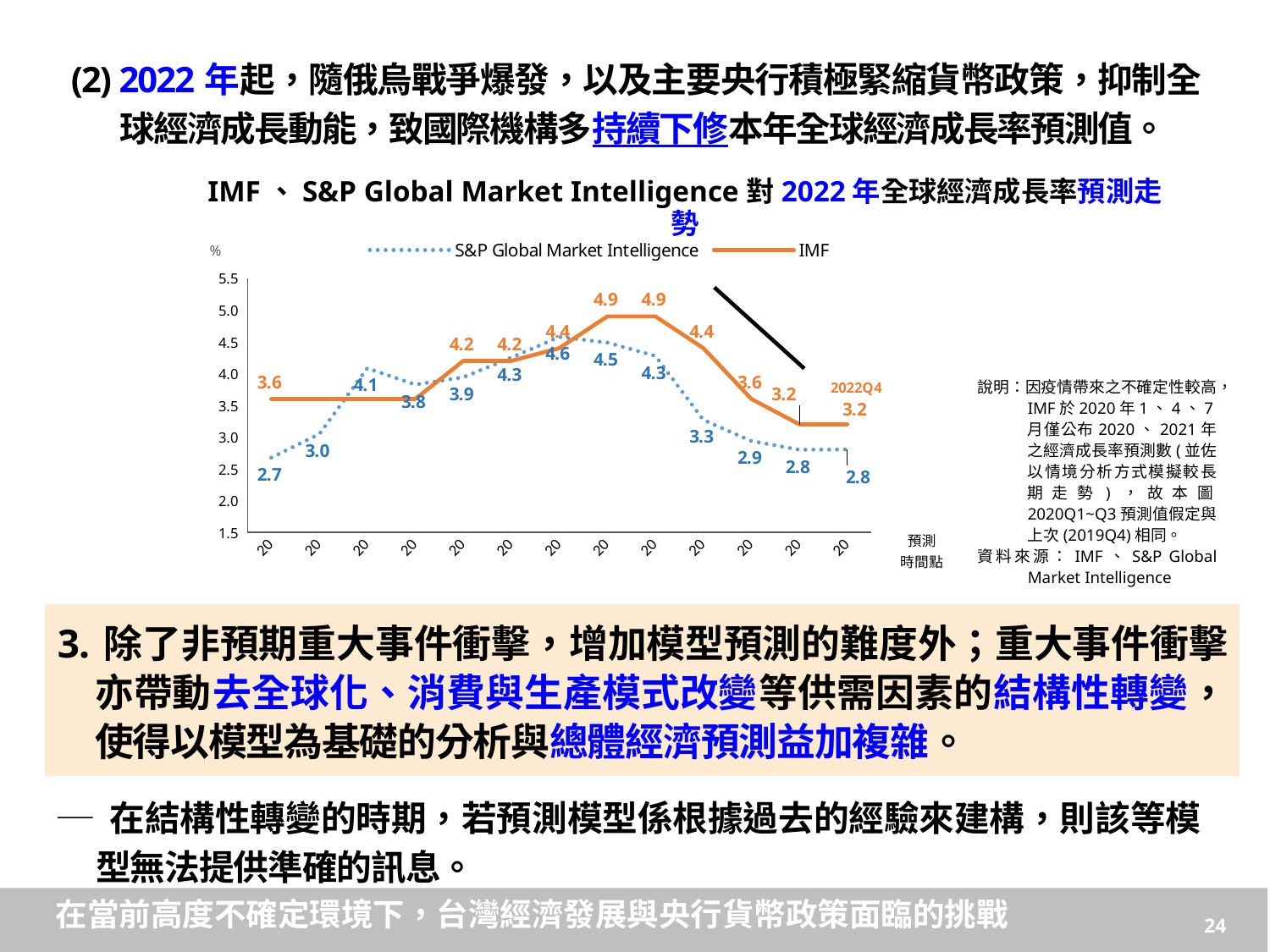
What is the highest value reached by the IMF series? 4.9 Which two series are listed in the chart's legend? S&P Global Market Intelligence and IMF What is the S&P Global Market Intelligence forecast value at the 2022Q4 point? 2.8 What unit is shown on the chart's vertical axis? % At the 2022Q4 point, what is the difference between the IMF value and the S&P Global Market Intelligence value? 0.4 At the 2022Q4 point, which series has the larger value, IMF or S&P Global Market Intelligence? IMF What is the lowest value of the S&P Global Market Intelligence series? 2.7 How many series does the chart's legend list? 2 What is the highest value reached by the S&P Global Market Intelligence series? 4.6 Do the forecast values rise or fall over the last several points of the chart leading up to 2022Q4? Fall What kind of chart is shown on the slide? Line chart What is the IMF forecast value at the 2022Q4 point? 3.2